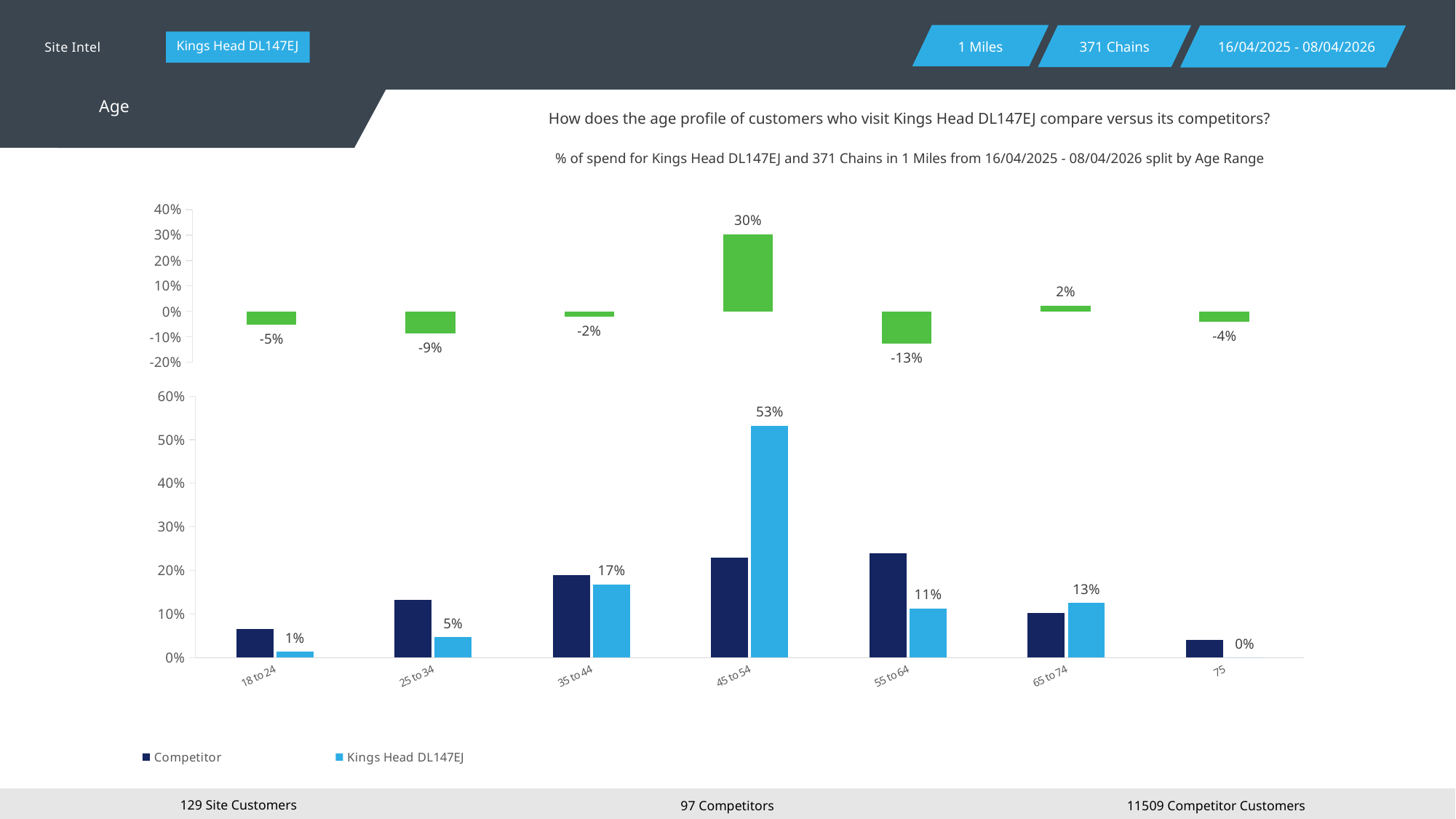
In the bottom chart, what is the value for Kings Head DL147EJ in the 45 to 54 age range? 53% How many series does the legend of the bottom chart list? 2 In the bottom chart, which age range has the highest value for Kings Head DL147EJ? 45 to 54 In the bottom chart, for the 18 to 24 age range, which is larger: Competitor or Kings Head DL147EJ? Competitor In the bottom chart, what is the value for Kings Head DL147EJ in the 65 to 74 age range? 13% In the bottom chart, is the Competitor value for 45 to 54 greater or less than 20%? greater In the top chart, which age range has the highest value? 45 to 54 In the bottom chart, what is the difference between the Kings Head DL147EJ values for 45 to 54 and 35 to 44? 36% In the top chart, what is the value for the 55 to 64 age range? -13% What type of chart is the bottom chart? bar chart In the top chart, which age range has the lowest value? 55 to 64 How many age range categories are shown in the bottom chart? 7